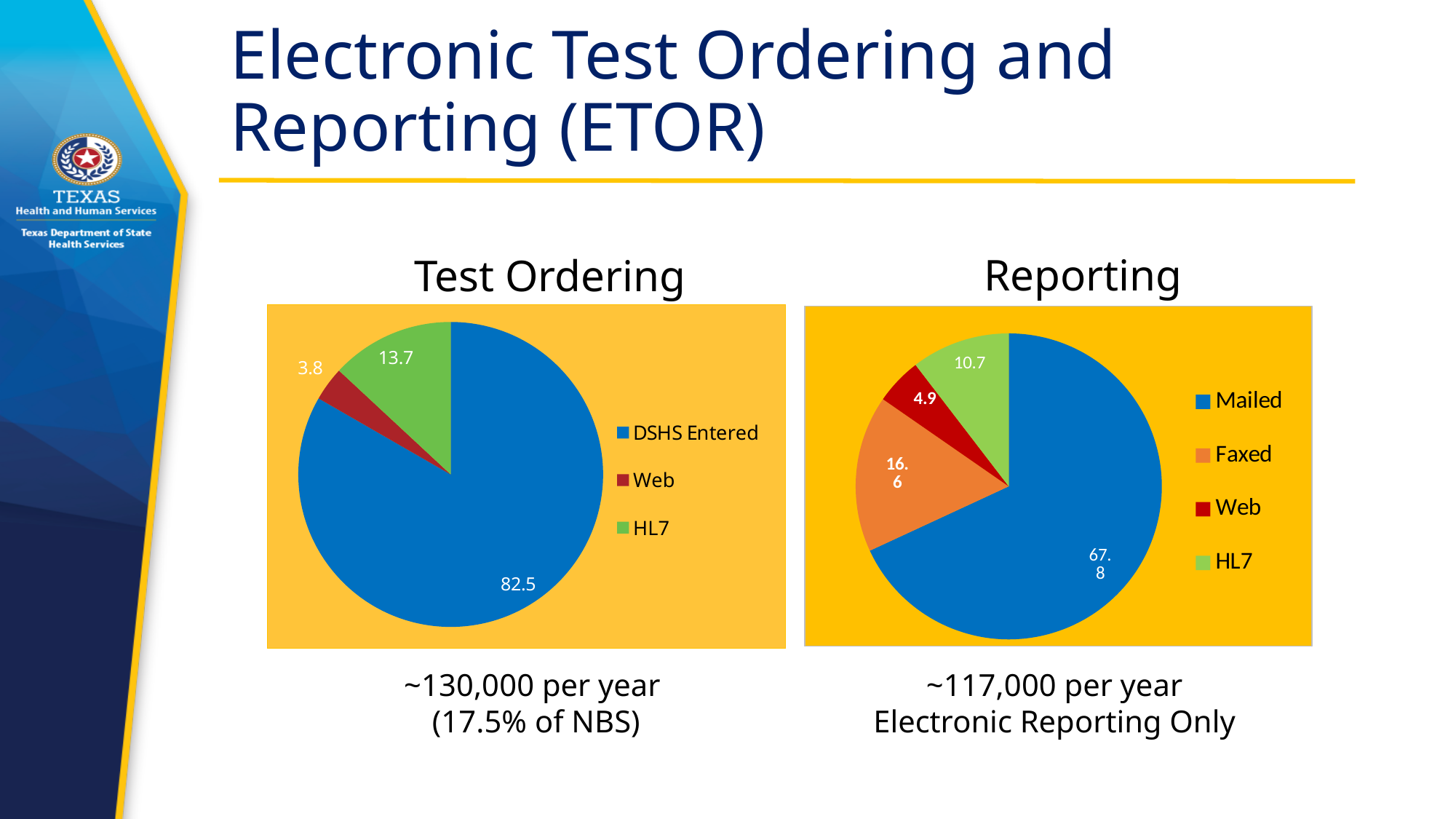
In the Reporting pie chart, what is the difference between the Faxed and HL7 values? 5.9 In the Test Ordering pie chart, what is the value for DSHS Entered? 82.5 In the Test Ordering pie chart, what is the value for Web? 3.8 In the Reporting pie chart, what is the value for Mailed? 67.8 What type of chart is used for Test Ordering? Pie chart In the Test Ordering pie chart, which category has the largest slice? DSHS Entered In the Reporting pie chart, which category has the smallest slice? Web In the Test Ordering pie chart, what is the value for HL7? 13.7 How many categories does the legend of the Reporting pie chart list? 4 In the Reporting pie chart, what colour is the Faxed slice? Orange In the Reporting pie chart, what is the value for Faxed? 16.6 In the Test Ordering pie chart, which is larger, HL7 or Web? HL7